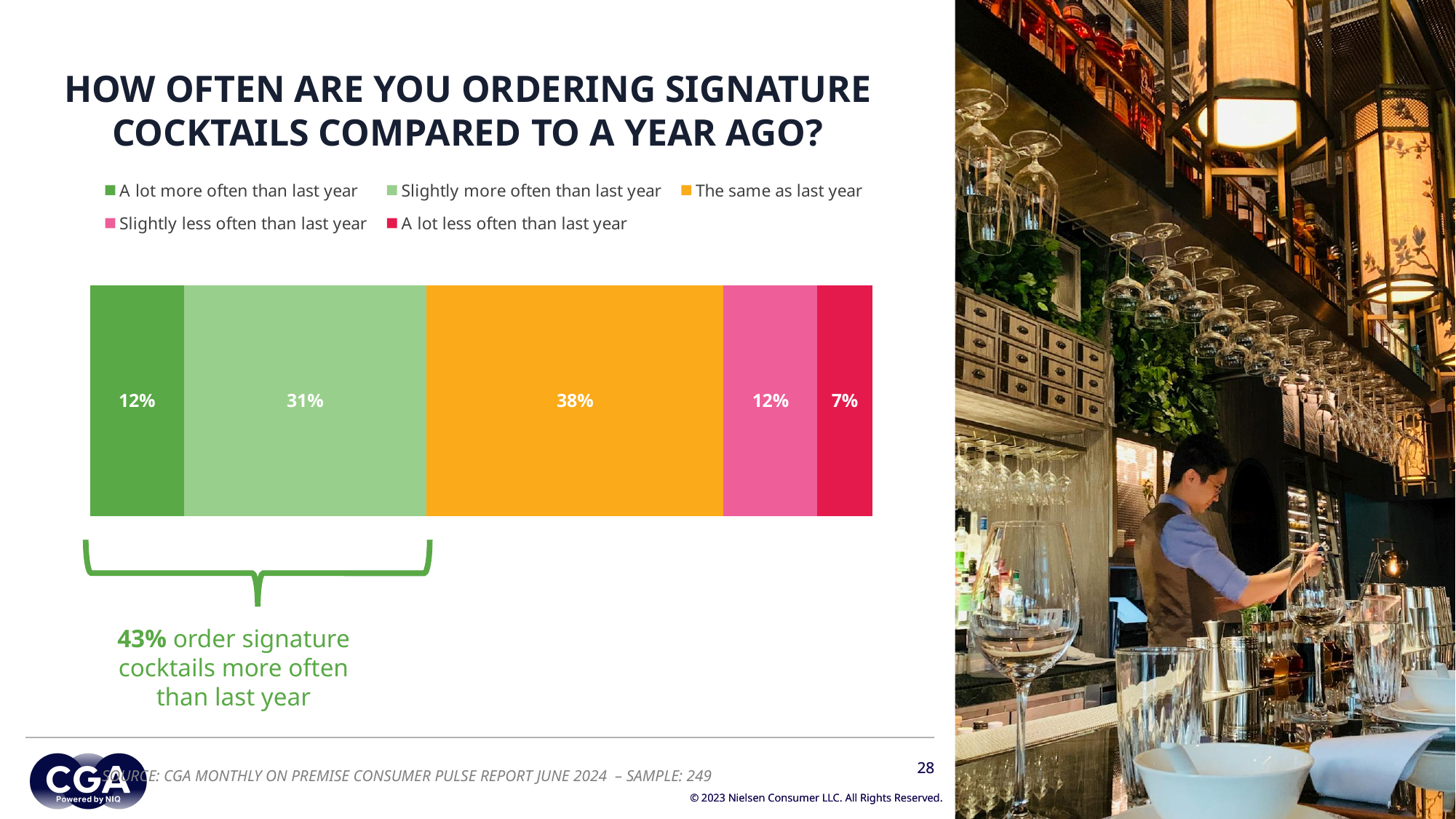
What is the combined share of respondents who order signature cocktails more often than last year (a lot more plus slightly more)? 43% What colour represents 'The same as last year' in the chart? Orange What percentage of respondents say they order signature cocktails a lot more often than last year? 12% What percentage of respondents say they order signature cocktails the same as last year? 38% Which response category has the largest share? The same as last year Which is larger: the share for 'Slightly more often than last year' or the share for 'Slightly less often than last year'? Slightly more often than last year What percentage of respondents say they order signature cocktails slightly more often than last year? 31% What kind of chart is shown on the slide? Stacked bar chart How many response categories does the legend list? 5 What is the difference between the share for 'The same as last year' and the share for 'Slightly more often than last year'? 7% What percentage of respondents say they order signature cocktails a lot less often than last year? 7% Which response category has the smallest share? A lot less often than last year